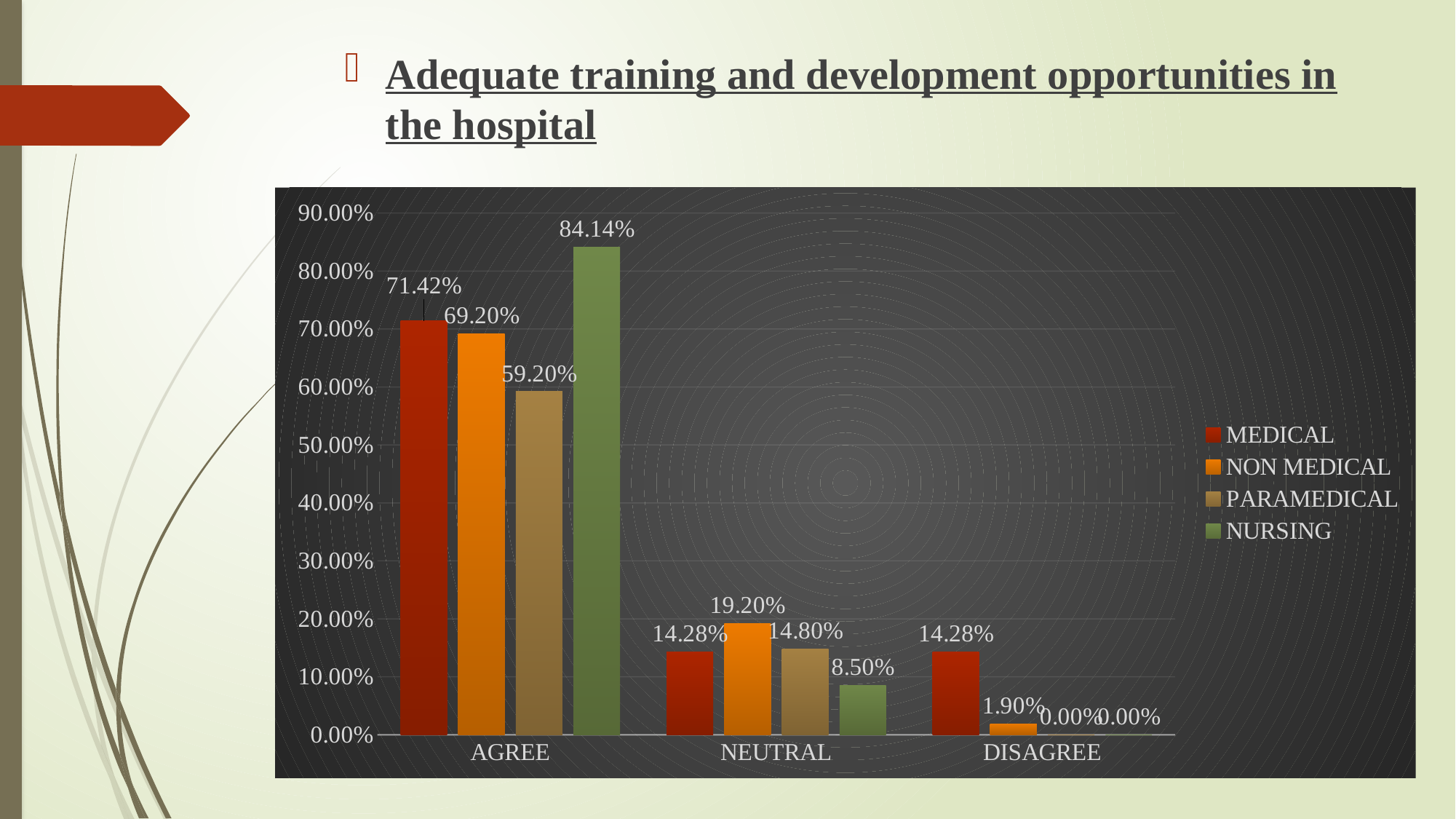
What is the value for MEDICAL in the AGREE category? 71.42% What is the value for NON MEDICAL in the NEUTRAL category? 19.20% How many series does the legend list? 4 Which series has the lowest value in the NEUTRAL category? NURSING What is the difference between the NURSING and PARAMEDICAL values in the AGREE category? 24.94% In the AGREE category, which is larger: the MEDICAL value or the NON MEDICAL value? MEDICAL What is the value for NURSING in the AGREE category? 84.14% Which series is shown in green in the legend? NURSING What is the value for NON MEDICAL in the DISAGREE category? 1.90% Which series has the highest value in the AGREE category? NURSING What kind of chart is shown on the slide? Bar chart How many categories are shown on the x axis? 3